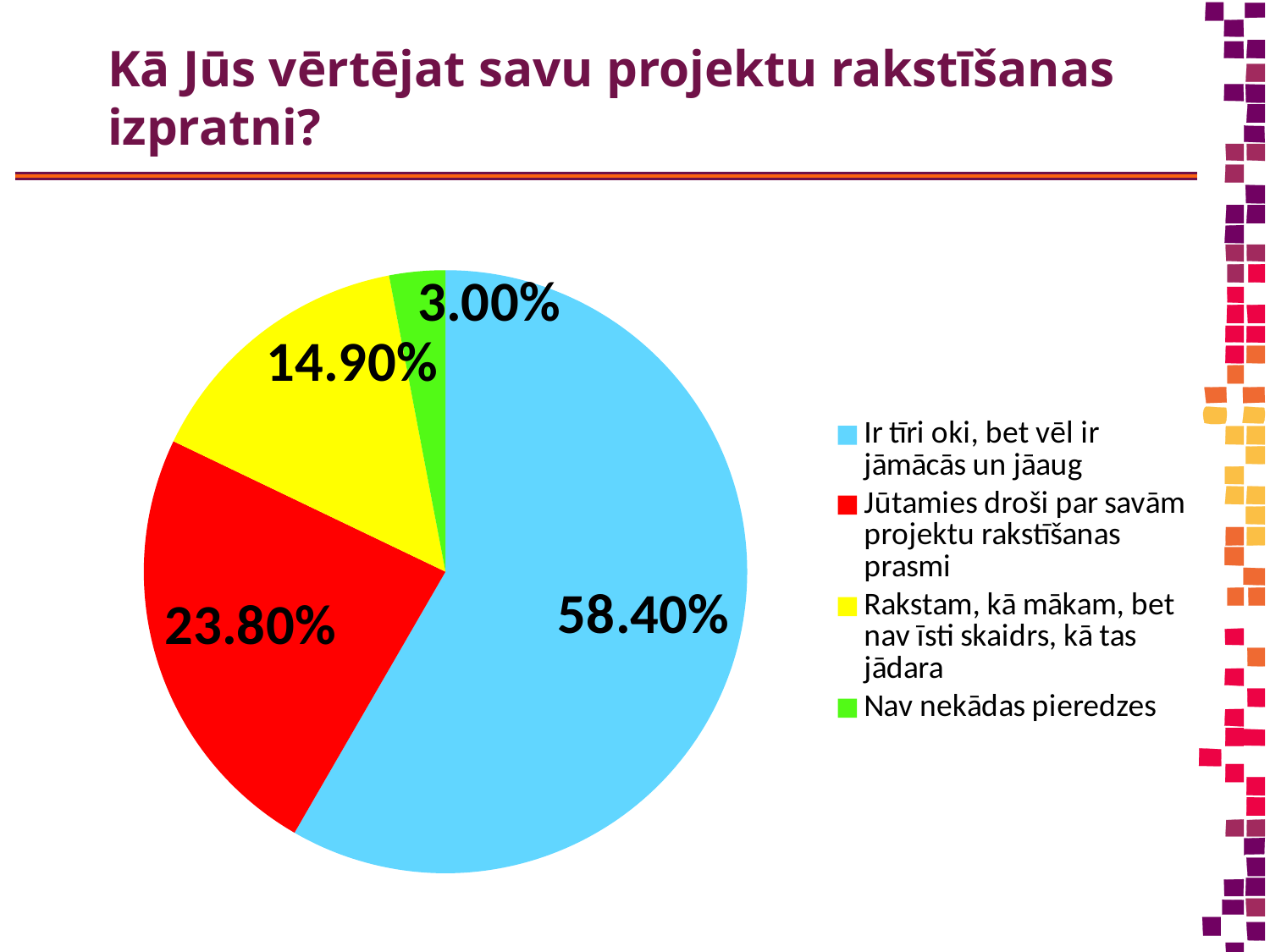
What is the title of the slide containing the pie chart? Kā Jūs vērtējat savu projektu rakstīšanas izpratni? Which category has the largest slice of the pie? Ir tīri oki, bet vēl ir jāmācās un jāaug What share of the pie is labelled "Jūtamies droši par savām projektu rakstīšanas prasmi"? 23.80% What share of the pie is labelled "Nav nekādas pieredzes"? 3.00% What share of the pie is labelled "Ir tīri oki, bet vēl ir jāmācās un jāaug"? 58.40% What colour is the slice for "Nav nekādas pieredzes"? green What is the difference between the "Jūtamies droši par savām projektu rakstīšanas prasmi" slice and the "Rakstam, kā mākam, bet nav īsti skaidrs, kā tas jādara" slice? 8.90% How many categories does the pie chart show? 4 What kind of chart is shown on the slide? pie chart Which category has the smallest slice of the pie? Nav nekādas pieredzes Which is larger: the "Rakstam, kā mākam, bet nav īsti skaidrs, kā tas jādara" slice or the "Nav nekādas pieredzes" slice? Rakstam, kā mākam, bet nav īsti skaidrs, kā tas jādara What share of the pie is labelled "Rakstam, kā mākam, bet nav īsti skaidrs, kā tas jādara"? 14.90%